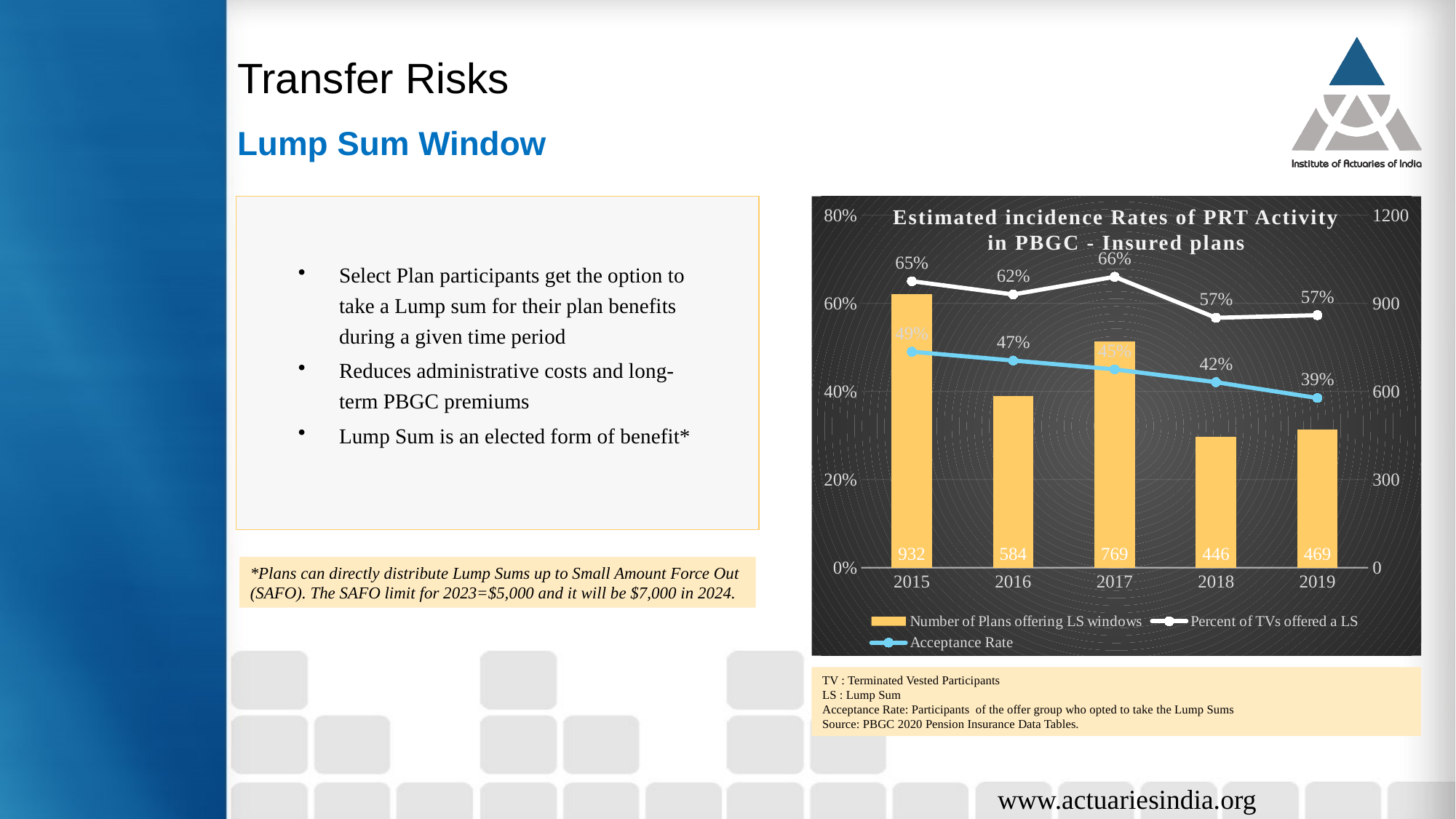
What kind of chart is this? Combined bar and line chart What is the acceptance rate in 2019? 39% What is the percent of TVs offered a LS in 2017? 66% What is the number of plans offering LS windows in 2015? 932 How many series does the legend list? 3 Which is larger, the number of plans offering LS windows in 2017 or in 2019? 2017 What is the difference between the number of plans offering LS windows in 2015 and in 2016? 348 Which year has the highest number of plans offering LS windows? 2015 How many years are shown on the x axis? 5 Does the acceptance rate rise or fall from 2015 to 2019? Fall What is the title of the chart? Estimated incidence Rates of PRT Activity in PBGC - Insured plans Which year has the lowest number of plans offering LS windows? 2018